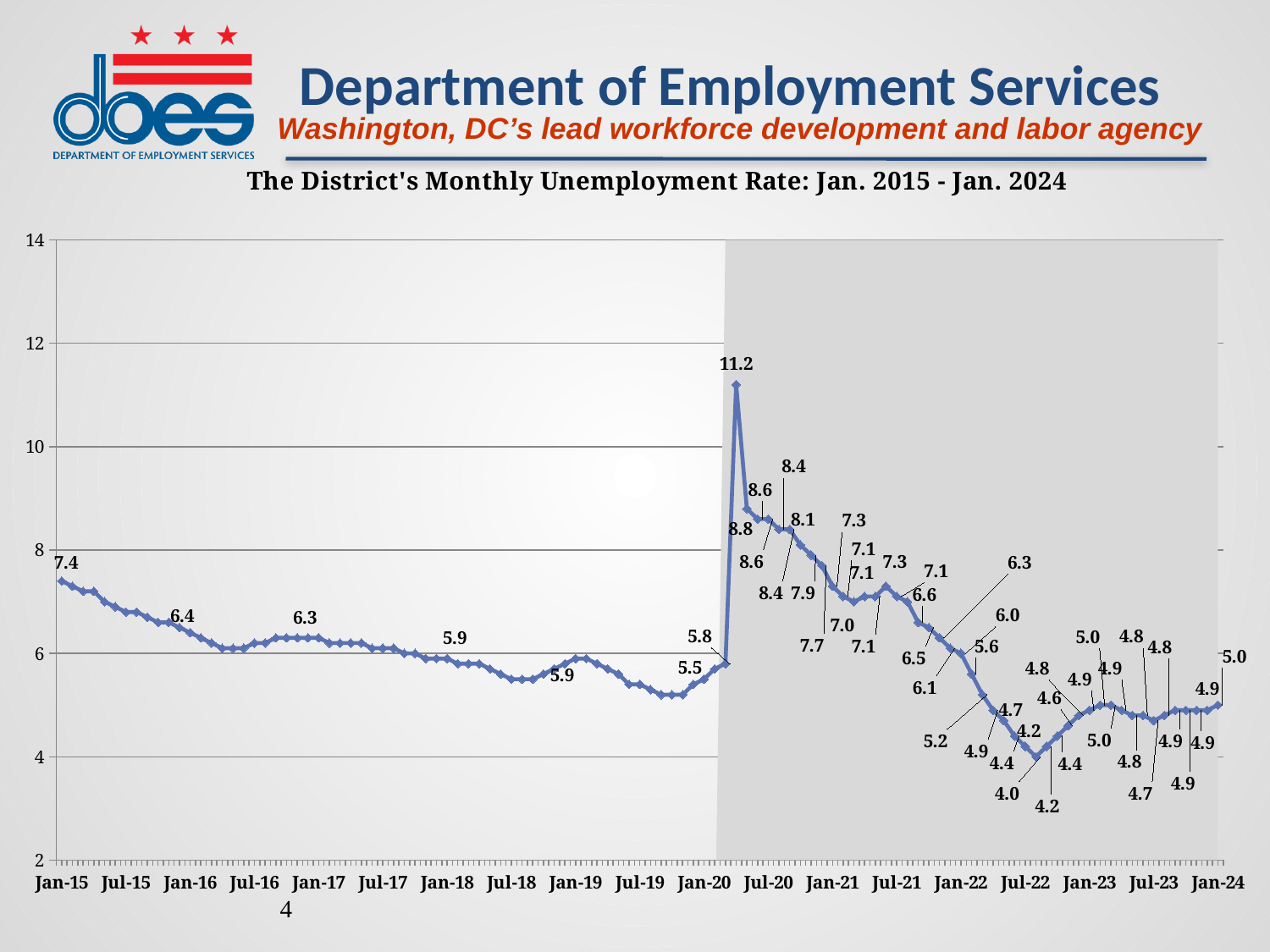
Is the unemployment rate at Jan-20 greater or less than 6? less What is the unemployment rate shown for Jan-15, the first point on the chart? 7.4 Which is higher, the unemployment rate at Jan-15 or at Jan-24? Jan-15 What kind of chart is shown on the slide? line chart What is the lowest unemployment rate labeled on the chart? 4.0 What is the unemployment rate shown for Jan-24, the last point on the chart? 5.0 What is the highest unemployment rate labeled on the chart? 11.2 What is the maximum value shown on the vertical axis? 14 What is the title of the chart? The District's Monthly Unemployment Rate: Jan. 2015 - Jan. 2024 What is the difference between the peak rate of 11.2 and the Jan-15 rate of 7.4? 3.8 What is the difference between the Jan-15 rate and the Jan-24 rate? 2.4 Does the unemployment rate rise or fall between Jan-15 and Jan-16? fall